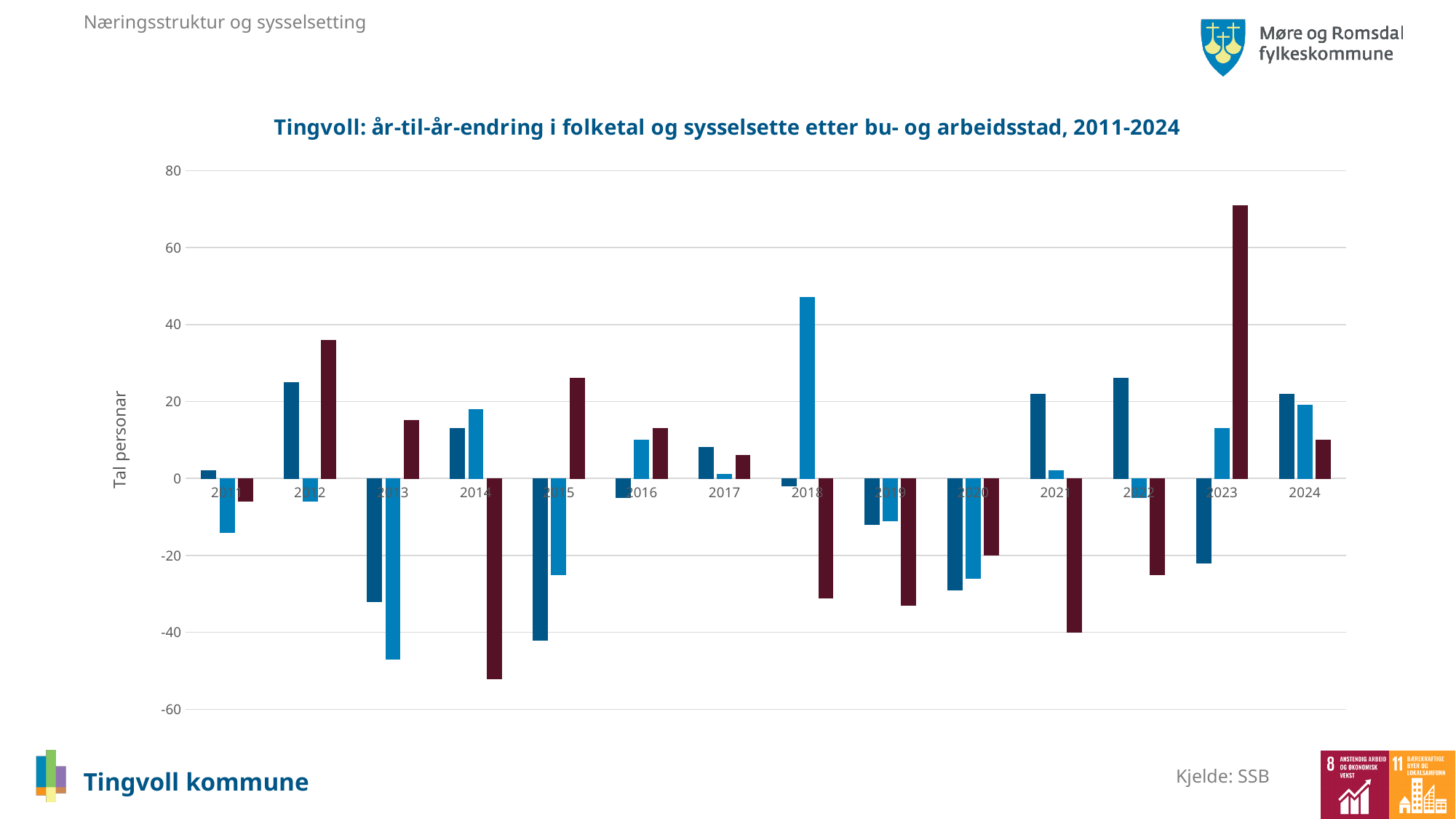
In which year does the dark red series reach its lowest value? 2014 Which is larger in 2021: the dark blue bar or the dark red bar? the dark blue bar How many years are shown along the x axis of the chart? 14 What is the label on the vertical axis of the chart? Tal personar What is the title of the chart? Tingvoll: år-til-år-endring i folketal og sysselsette etter bu- og arbeidsstad, 2011-2024 Is the value of the dark red bar in 2023 greater or less than 60? greater In which year does the light blue series reach its lowest value? 2013 In which year does the dark red series reach its highest value? 2023 Is the value of the dark red bar in 2014 greater or less than -40? less In which year does the light blue series reach its highest value? 2018 What kind of chart is shown on the slide? bar chart Is the value of the light blue bar in 2018 greater or less than 40? greater